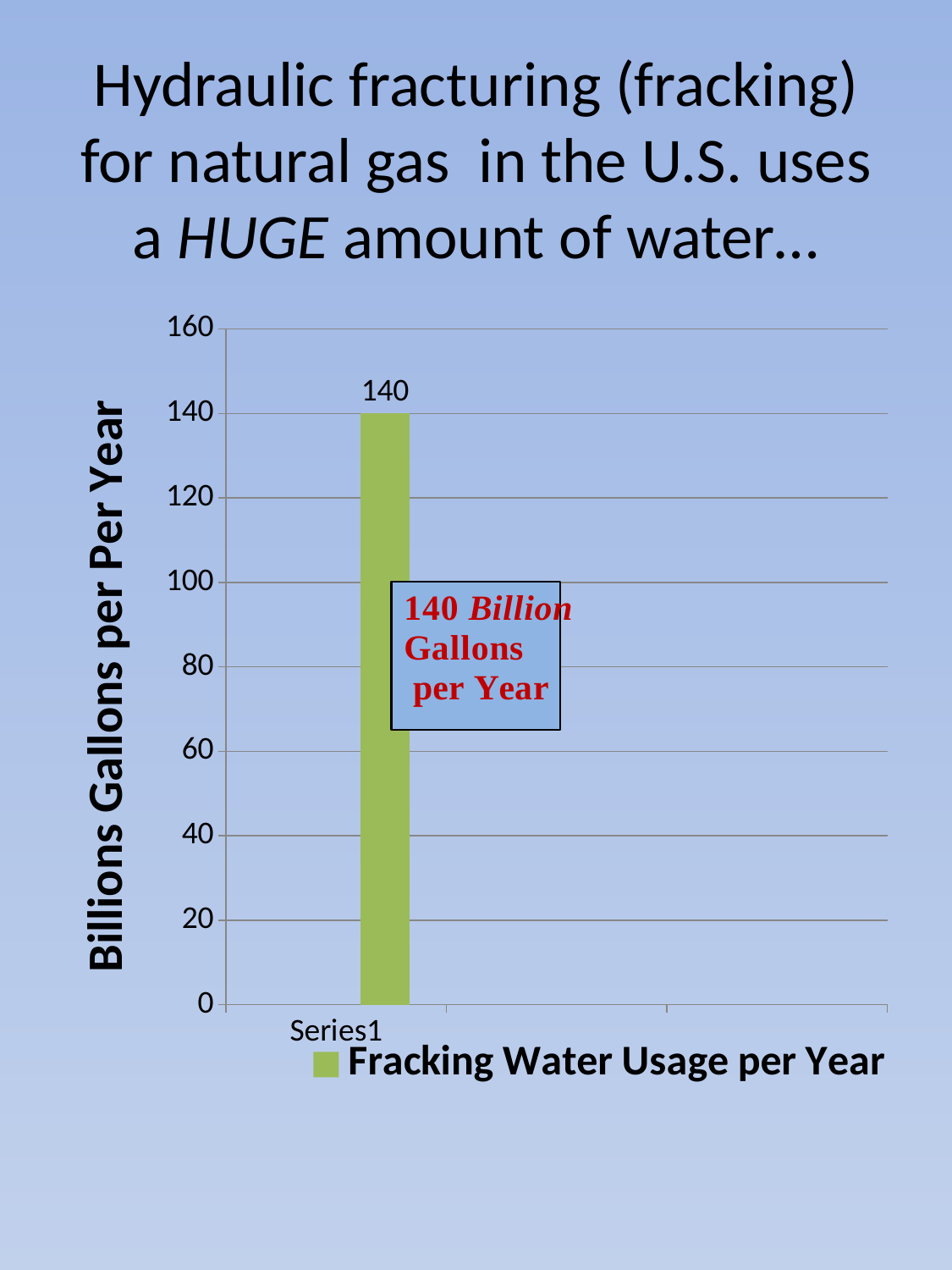
How many series does the legend list? 1 What is the title of the vertical axis? Billions Gallons per Per Year What is the category label shown under the bar? Series1 What kind of chart is shown on the slide? bar chart How many bars are plotted in the chart? 1 What is the maximum value shown on the vertical axis? 160 Is the value for Series1 greater or less than 160? less What is the value of the bar labelled Series1? 140 Is the value for Series1 greater or less than 120? greater What is the label of the series shown in the legend? Fracking Water Usage per Year